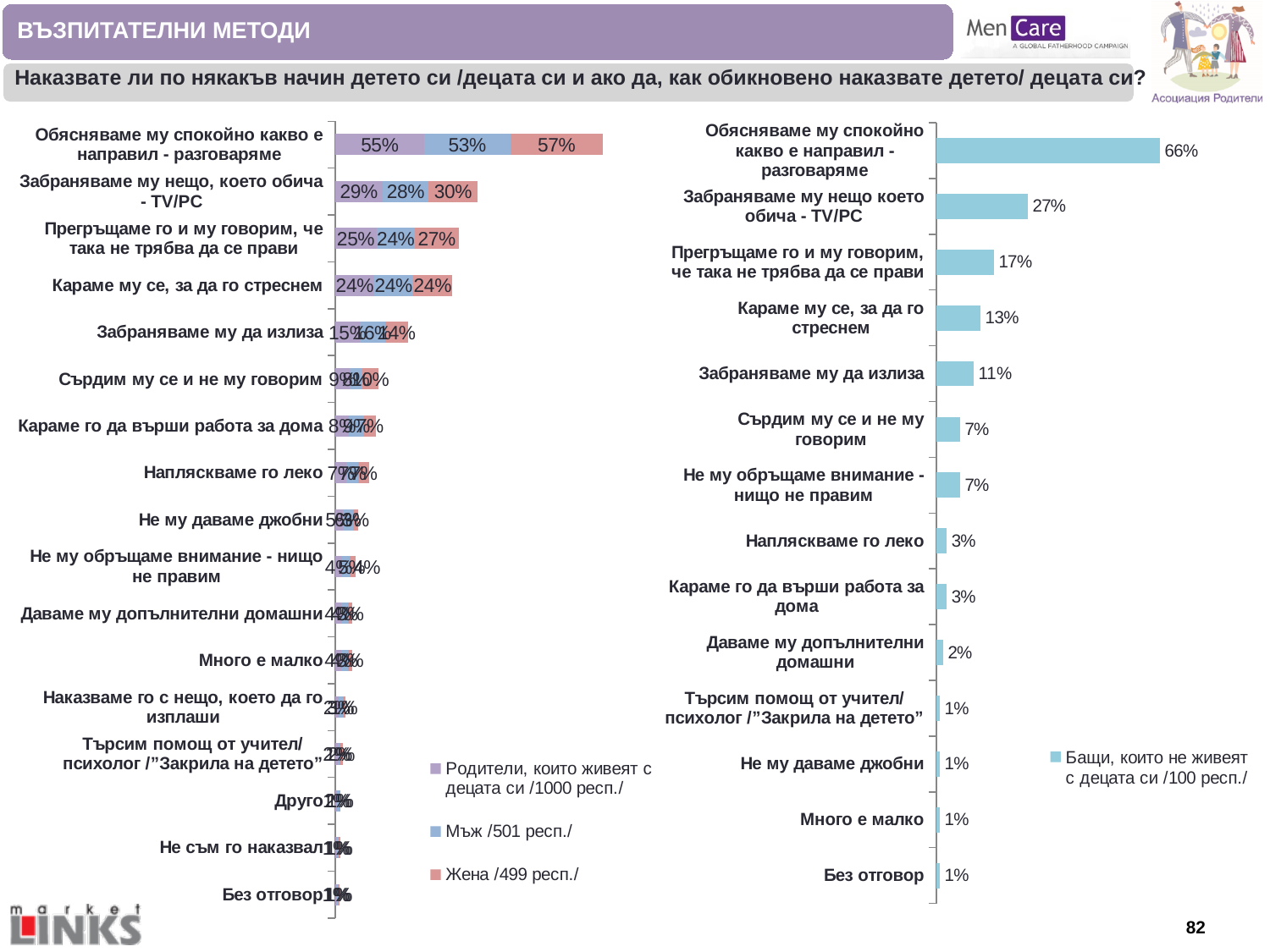
In the left chart, what is the value for "Родители, които живеят с децата си /1000 респ./" for "Забраняваме му нещо, което обича - TV/PC"? 29% In the right chart (Бащи, които не живеят с децата си), what is the value for "Забраняваме му нещо което обича - TV/PC"? 27% In the left chart, what is the value for "Жена /499 респ./" for "Обясняваме му спокойно какво е направил - разговаряме"? 57% In the right chart (Бащи, които не живеят с децата си), what is the difference between "Прегръщаме го и му говорим, че така не трябва да се прави" and "Караме му се, за да го стреснем"? 4% In the left chart, how many series does the legend list? 3 What kind of chart is the right chart (Бащи, които не живеят с децата си)? Bar chart In the right chart (Бащи, които не живеят с децата си), which category has the highest value? Обясняваме му спокойно какво е направил - разговаряме In the right chart (Бащи, които не живеят с децата си), how many categories are shown? 14 In the left chart, what is the difference between the "Жена /499 респ./" and "Мъж /501 респ./" values for "Обясняваме му спокойно какво е направил - разговаряме"? 4% In the right chart (Бащи, които не живеят с децата си), what is the value for "Обясняваме му спокойно какво е направил - разговаряме"? 66% In the left chart, which is larger for "Прегръщаме го и му говорим, че така не трябва да се прави": the value for "Мъж /501 респ./" or for "Жена /499 респ./"? Жена /499 респ./ In the right chart (Бащи, които не живеят с децата си), what is the value for "Забраняваме му да излиза"? 11%